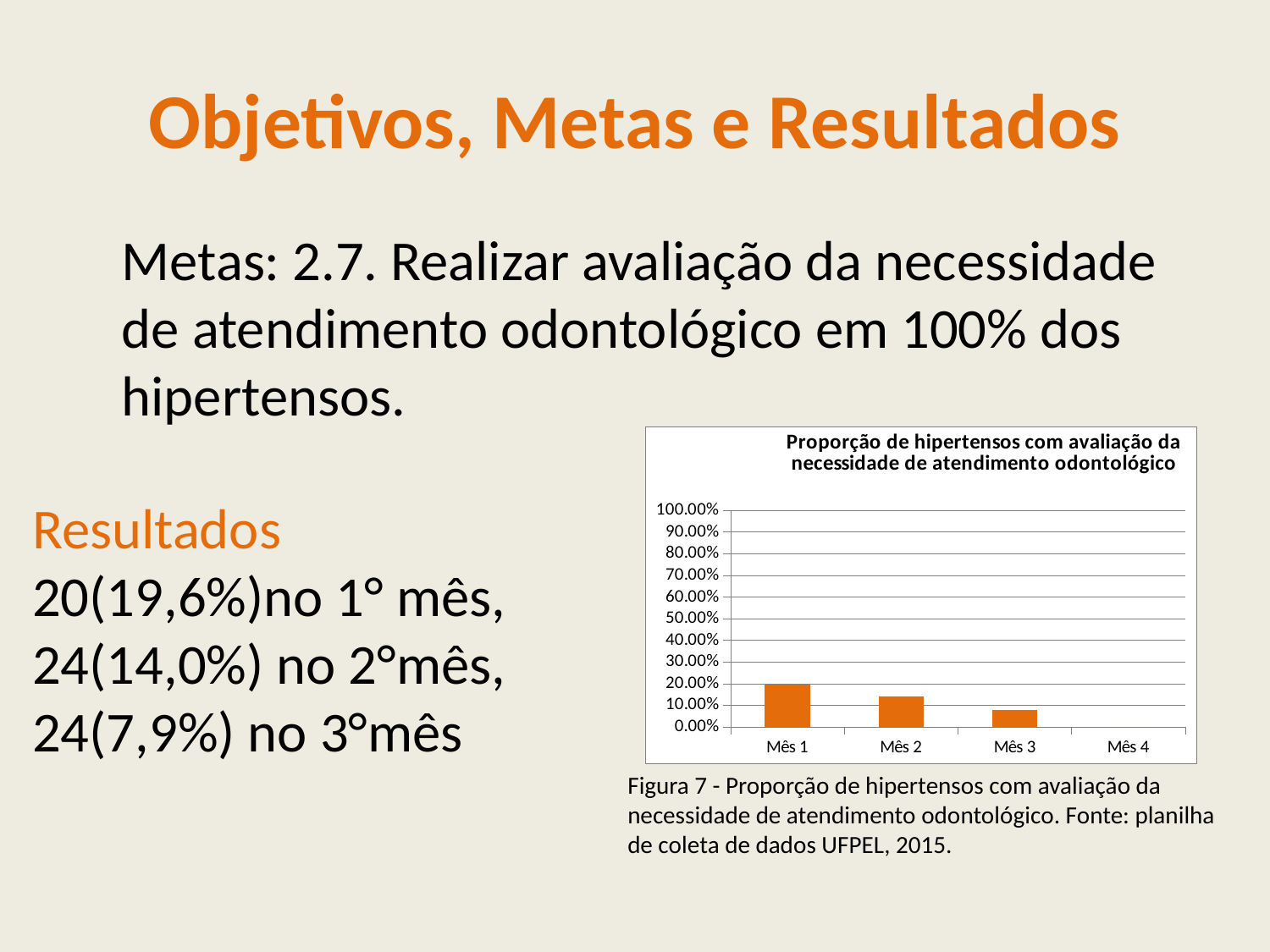
What is the maximum value shown on the y axis of the chart? 100.00% Do the bar values rise or fall from Mês 1 to Mês 3? fall Is the value for Mês 2 greater or less than 20.00%? less Is the value for Mês 1 greater or less than 30.00%? less How many month categories are shown on the x axis of the chart? 4 Is the value for Mês 3 greater or less than 10.00%? less Which month has the highest bar in the chart? Mês 1 Which is larger, the bar for Mês 2 or the bar for Mês 3? Mês 2 Among Mês 1, Mês 2 and Mês 3, which month has the lowest bar? Mês 3 What kind of chart is shown on the slide? bar chart What is the title of the chart on the slide? Proporção de hipertensos com avaliação da necessidade de atendimento odontológico